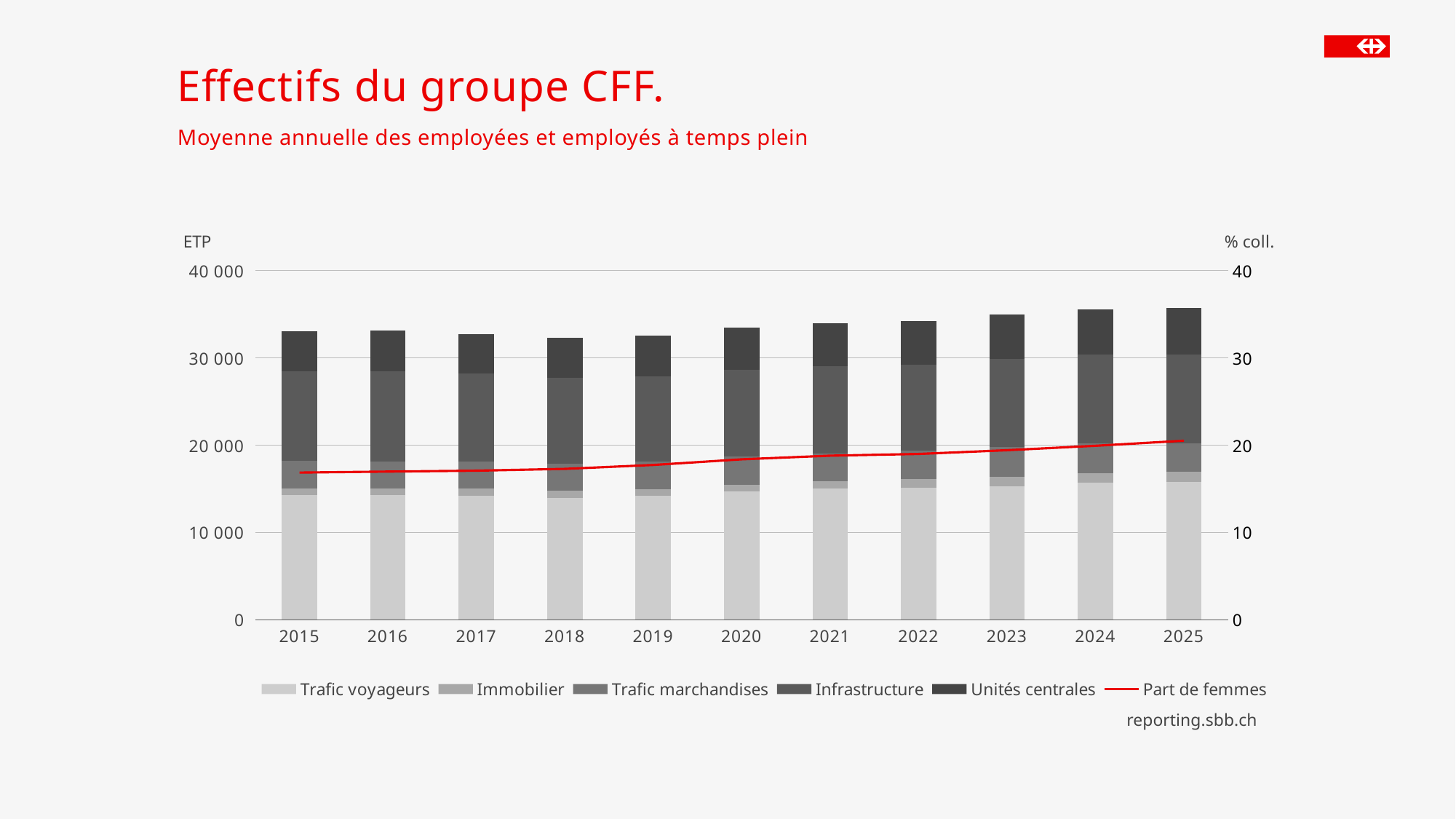
Which series is drawn as a red line rather than as bars? Part de femmes Is the Trafic voyageurs segment for 2015 greater or less than 10 000 ETP? greater Is the total stacked bar for 2015 greater or less than 30 000 ETP? greater What is the title of the chart on the slide? Effectifs du groupe CFF. How many years are shown on the x axis of the chart? 11 Is the total stacked bar for 2018 greater or less than 40 000 ETP? less Does the Part de femmes line rise or fall from 2015 to 2025? Rises What kind of chart is shown on the slide? Stacked bar chart with a line Which year has the larger total stacked bar, 2015 or 2025? 2025 How many series does the legend list? 6 Which year has the higher Part de femmes value, 2016 or 2024? 2024